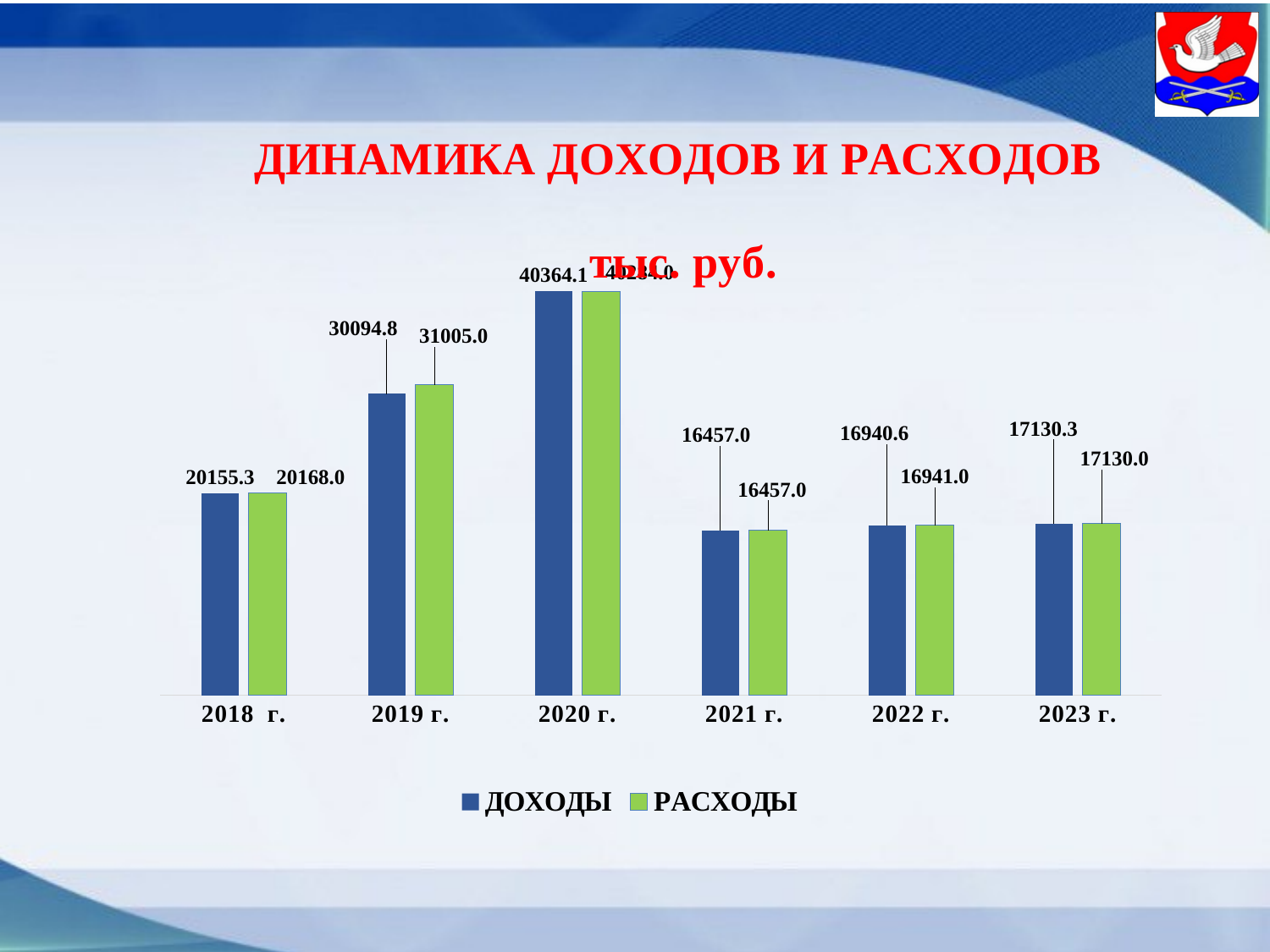
In which year is ДОХОДЫ lowest? 2021 г. What is the value of ДОХОДЫ for 2022 г.? 16940.6 How many years are shown on the x axis? 6 Does ДОХОДЫ rise or fall from 2018 г. to 2020 г.? Rise How many series does the legend list? 2 What is the value of РАСХОДЫ for 2023 г.? 17130.0 What is the value of ДОХОДЫ for 2018 г.? 20155.3 What is the difference between РАСХОДЫ and ДОХОДЫ in 2019 г.? 910.2 In 2019 г., which is larger: ДОХОДЫ or РАСХОДЫ? РАСХОДЫ In which year is ДОХОДЫ highest? 2020 г. What is the value of РАСХОДЫ for 2019 г.? 31005.0 What kind of chart is shown on the slide? Bar chart